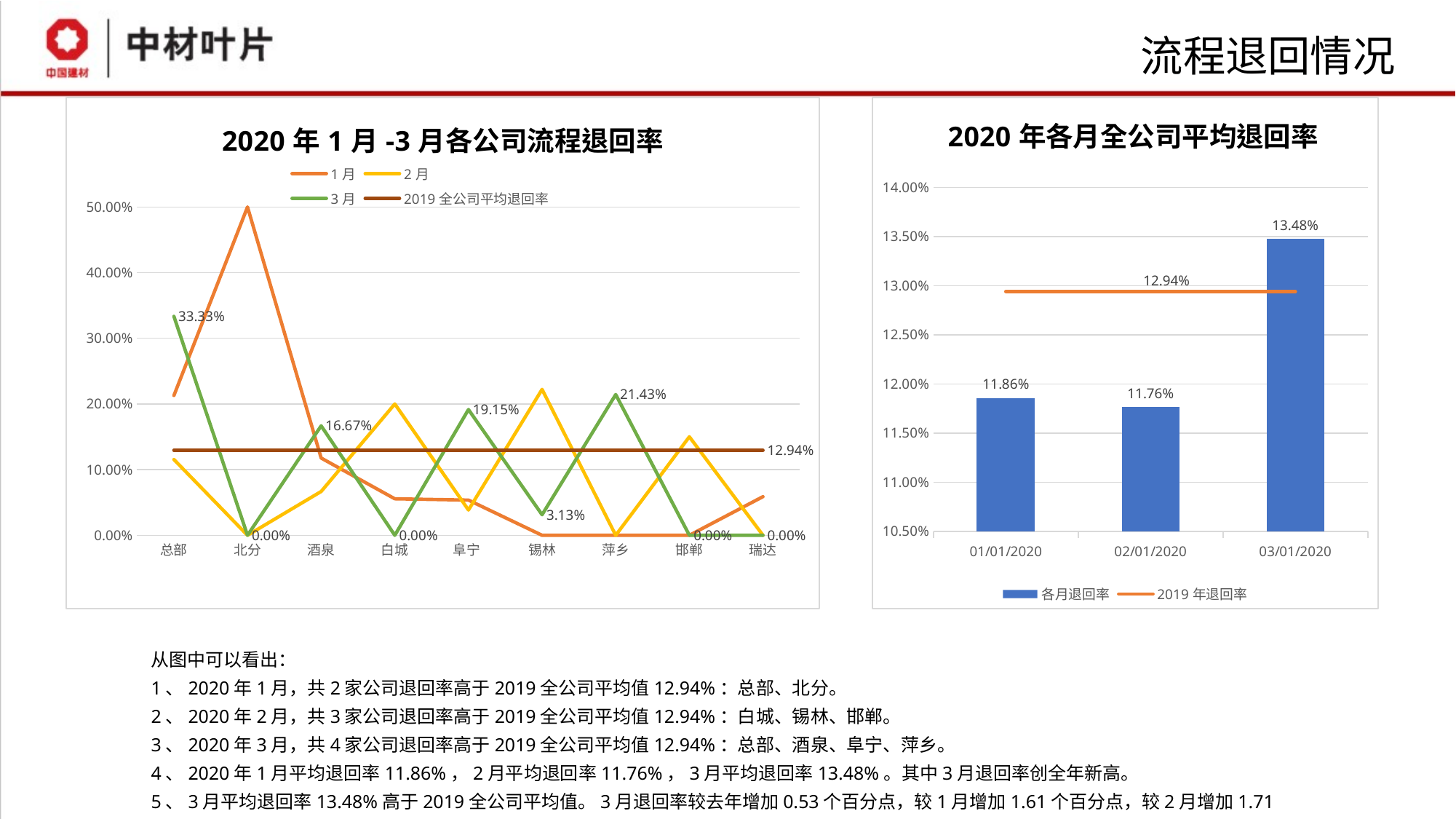
In the left chart (2020年1月-3月各公司流程退回率), is the 1月 value for 北分 greater or less than 40%? greater In the left chart (2020年1月-3月各公司流程退回率), what is the 3月 value for 总部? 33.33% In the left chart (2020年1月-3月各公司流程退回率), what is the 3月 value for 萍乡? 21.43% In the right chart (2020年各月全公司平均退回率), what is the difference between the values for 01/01/2020 and 02/01/2020? 0.10% In the right chart (2020年各月全公司平均退回率), which month has the highest return rate? 03/01/2020 In the right chart (2020年各月全公司平均退回率), how many bars are plotted? 3 In the left chart (2020年1月-3月各公司流程退回率), how many companies are shown on the x axis? 9 In the right chart (2020年各月全公司平均退回率), what is the value for 03/01/2020? 13.48% In the right chart (2020年各月全公司平均退回率), which month has the lowest return rate? 02/01/2020 In the left chart (2020年1月-3月各公司流程退回率), how many series does the legend list? 4 In the right chart (2020年各月全公司平均退回率), how many series does the legend list? 2 What kind of chart is the left chart (2020年1月-3月各公司流程退回率)? line chart